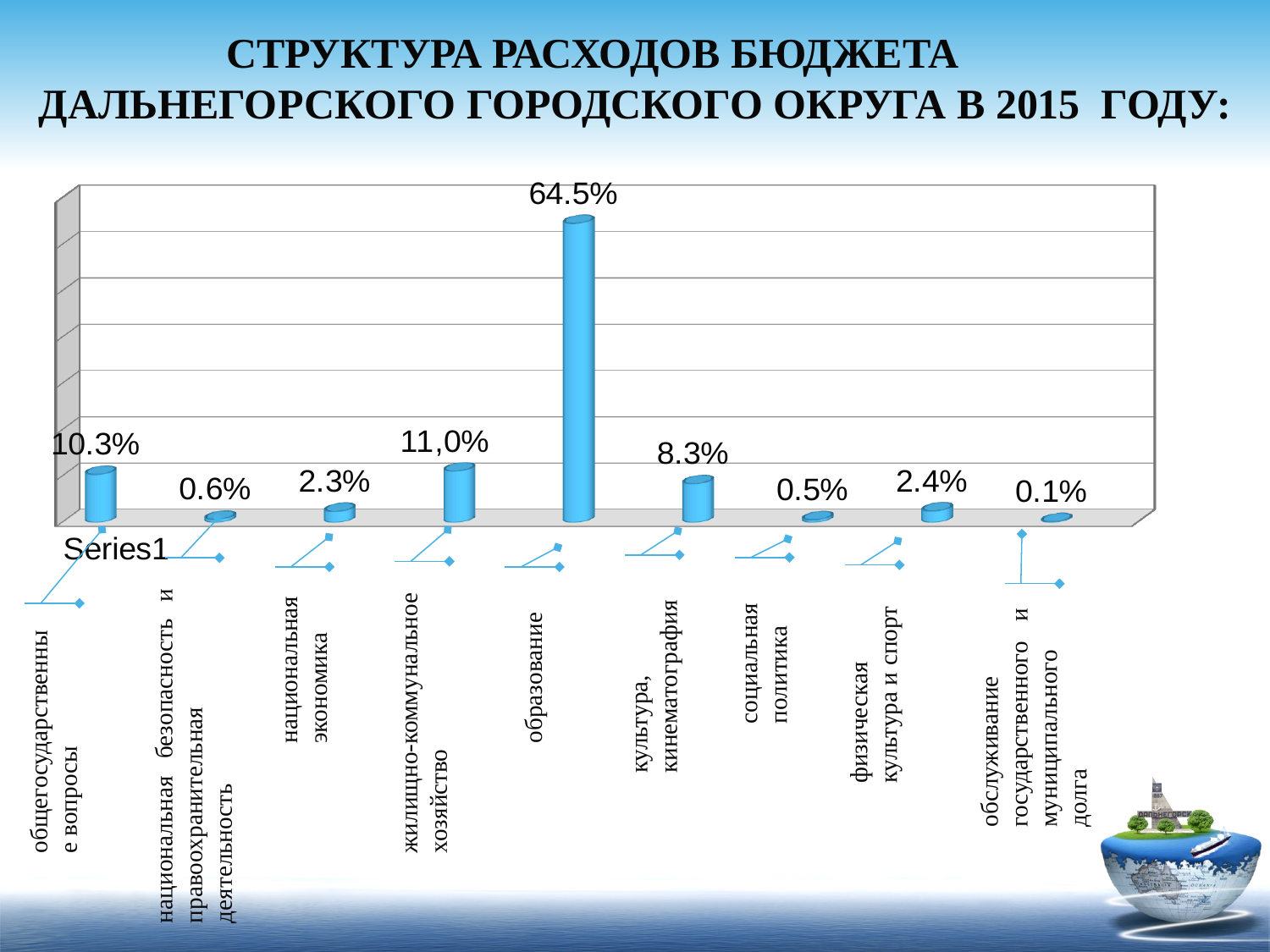
Which category has the lowest value? обслуживание государственного и муниципального долга What is the value for физическая культура и спорт? 2.4% What is the difference between the values for образование and жилищно-коммунальное хозяйство? 53.5% What is the value for жилищно-коммунальное хозяйство? 11,0% What is the value for общегосударственные вопросы? 10.3% What is the title of the slide? СТРУКТУРА РАСХОДОВ БЮДЖЕТА ДАЛЬНЕГОРСКОГО ГОРОДСКОГО ОКРУГА В 2015 ГОДУ: Which category has the highest value? образование What type of chart is shown on the slide? bar chart How many categories are shown in the chart? 9 What is the value for образование? 64.5% What is the value for культура, кинематография? 8.3% Which is larger, the value for национальная экономика or the value for физическая культура и спорт? физическая культура и спорт